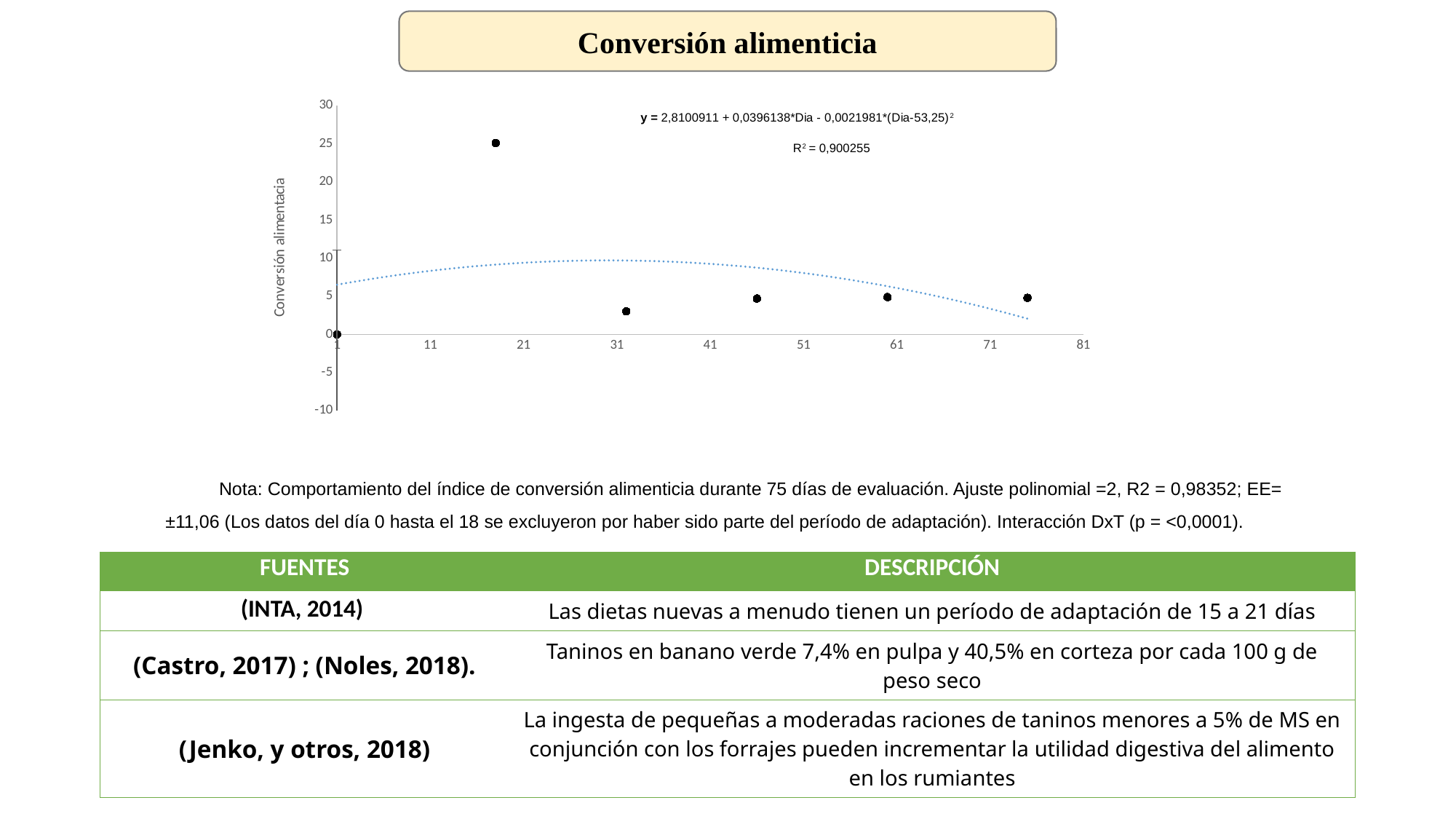
Is the value of the data point near day 31 greater or less than 5? less Around which x-axis value does the highest data point occur? Between 11 and 21 What kind of chart is shown on the slide? Scatter chart What is the title of the chart? Conversión alimenticia Is the value of the data point near day 75 greater or less than 0? greater Is the value of the data point near day 61 greater or less than 10? less What is the R² value printed on the chart? R² = 0,900255 How many data points are plotted in the chart? 6 What is the highest value shown on the y-axis? 30 Which is larger: the value of the data point near day 21 or the value of the data point near day 41? The point near day 21